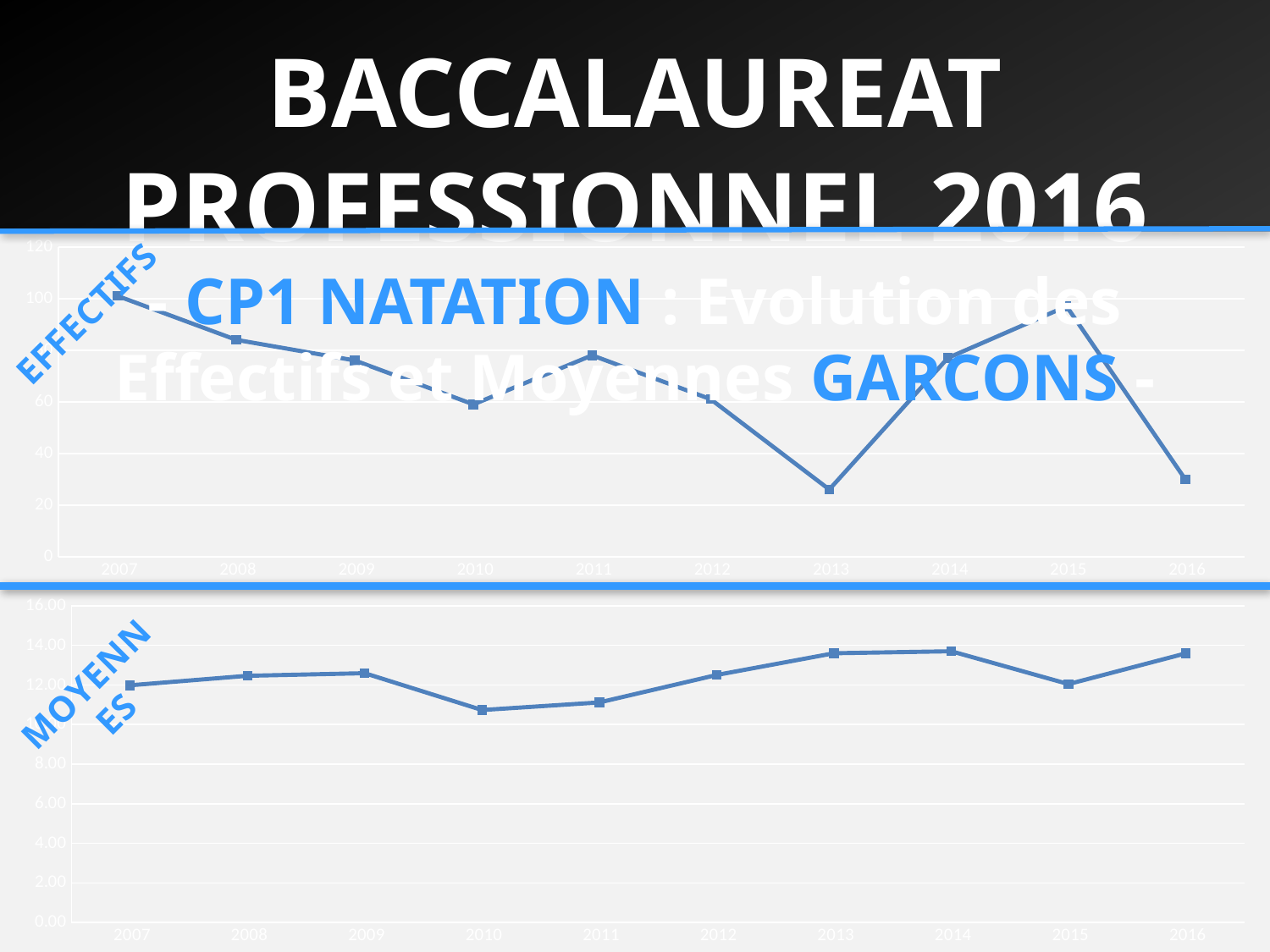
In the bottom chart (MOYENNES), is the value for 2013 greater or less than 12.00? greater How many years are plotted on the x axis of the bottom chart labelled MOYENNES? 10 In the top chart (EFFECTIFS), is the value for 2013 greater or less than 40? less What kind of chart is the top chart labelled EFFECTIFS? line chart In the top chart (EFFECTIFS), do the values rise or fall from 2007 to 2010? fall In the bottom chart (MOYENNES), do the values rise or fall from 2010 to 2014? rise What is the first year shown on the x axis of the top chart (EFFECTIFS)? 2007 In the top chart (EFFECTIFS), is the value for 2007 greater or less than 80? greater In the top chart (EFFECTIFS), which is larger, the value for 2007 or the value for 2013? 2007 In the bottom chart (MOYENNES), which is larger, the value for 2013 or the value for 2010? 2013